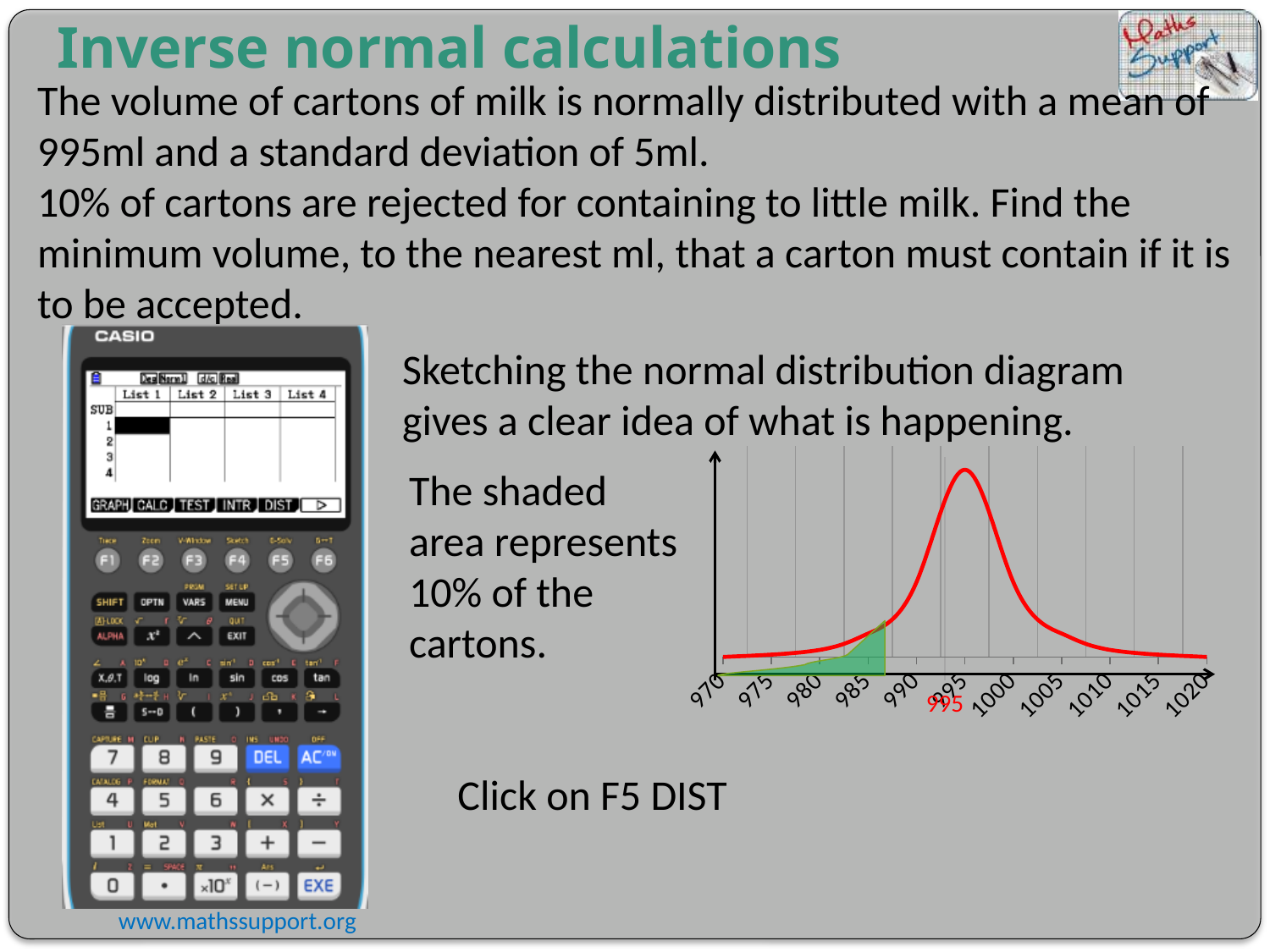
What is the spacing between consecutive x-axis tick labels on the chart? 5 How many tick labels are shown on the x axis of the chart? 11 What is the highest value labelled on the x axis of the chart? 1020 Does the red curve rise or fall as x increases from 970 to 995? rise Does the red curve rise or fall as x increases from 995 to 1020? fall What kind of chart is shown on the right of the slide? line chart At which x-axis value does the red curve reach its peak? 995 What is the lowest value labelled on the x axis of the chart? 970 Is the curve's value at 1000 greater or less than its value at 1015? greater Is the curve's value at 980 greater or less than its value at 995? less